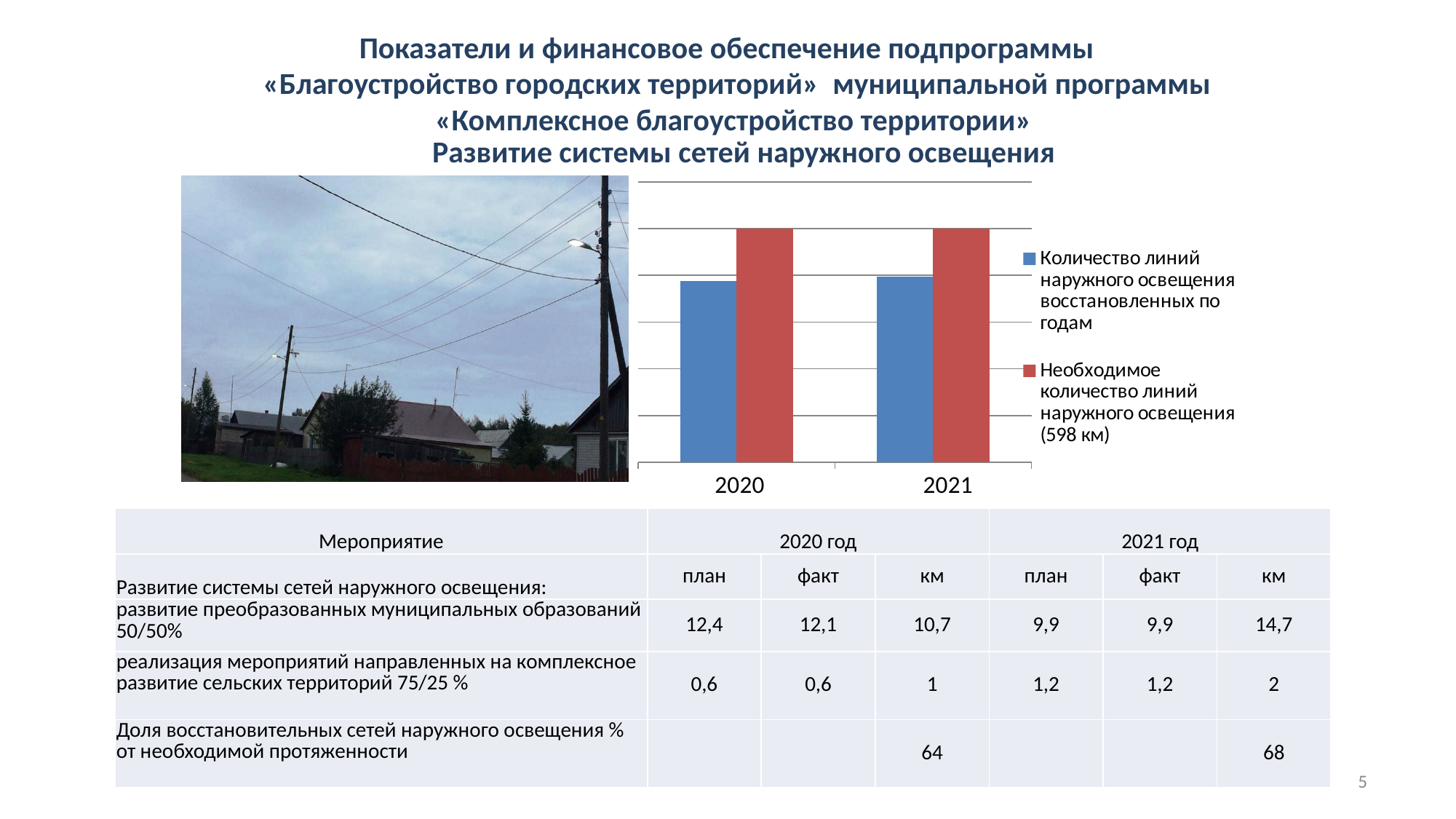
In the chart, for 2021, which series has the larger bar: 'Количество линий наружного освещения восстановленных по годам' or 'Необходимое количество линий наружного освещения (598 км)'? Необходимое количество линий наружного освещения (598 км) How many categories (years) are shown on the x axis of the chart? 2 Which years are shown on the x axis of the chart? 2020 and 2021 Does the bar for 'Необходимое количество линий наружного освещения (598 км)' change between 2020 and 2021 in the chart? No, it stays the same In the chart, for 2020, which series has the larger bar: 'Количество линий наружного освещения восстановленных по годам' or 'Необходимое количество линий наружного освещения (598 км)'? Необходимое количество линий наружного освещения (598 км) What kind of chart is shown on the slide? bar chart How many series does the chart's legend list? 2 What colour are the bars for the series 'Необходимое количество линий наружного освещения (598 км)' in the chart? red